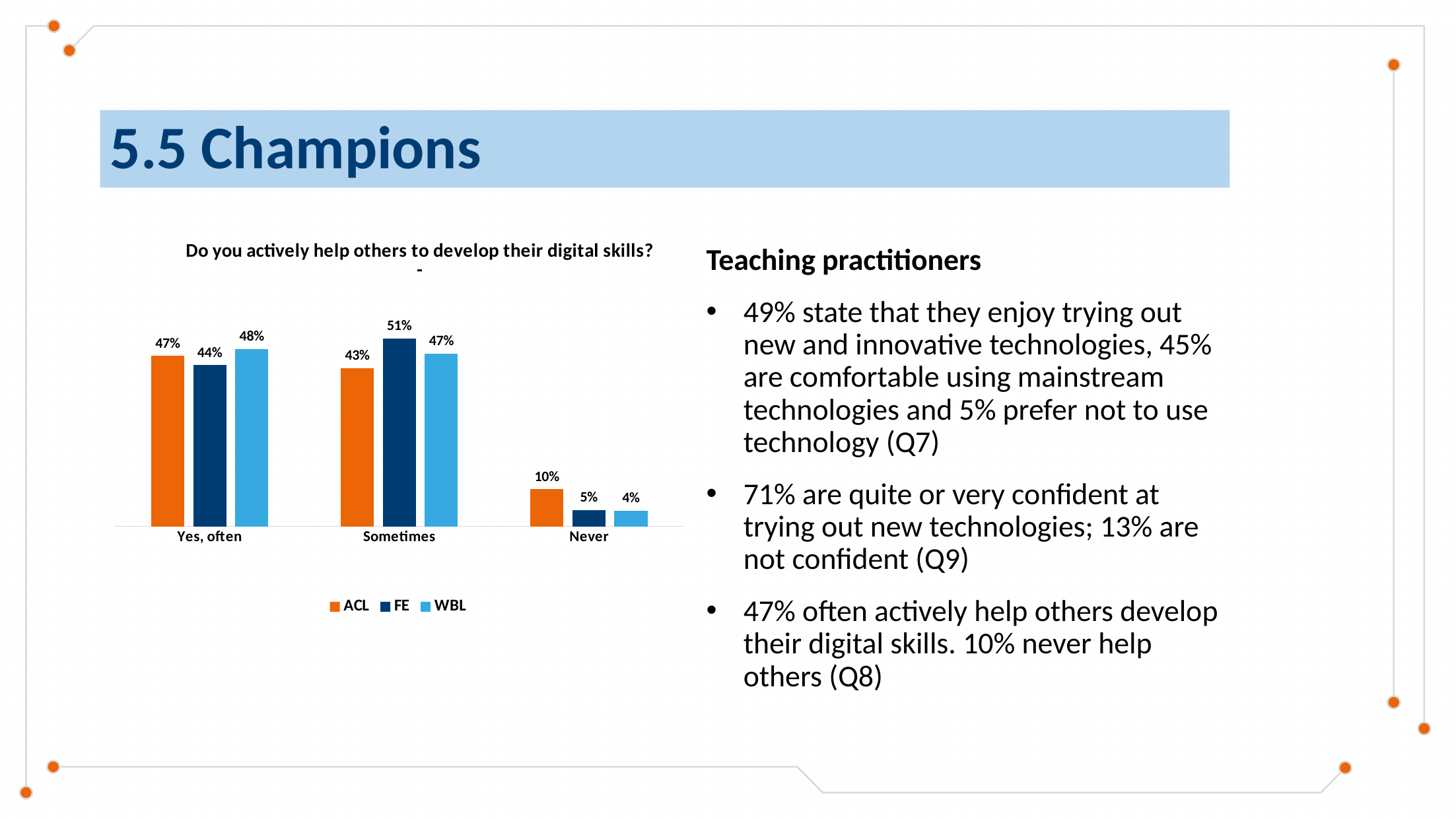
How many series does the legend list? 3 Which series is shown in orange in the legend? ACL What is the difference between the ACL and FE values in the 'Never' category? 5% How many categories are shown on the x axis? 3 What is the title of the chart? Do you actively help others to develop their digital skills? Which series has the lowest value in the 'Never' category? WBL Which is larger in the 'Yes, often' category: the value for FE or the value for WBL? WBL What is the value for ACL in the 'Yes, often' category? 47% Which series has the highest value in the 'Sometimes' category? FE What kind of chart is shown on the slide? Bar chart What is the value for WBL in the 'Never' category? 4% What is the value for FE in the 'Sometimes' category? 51%